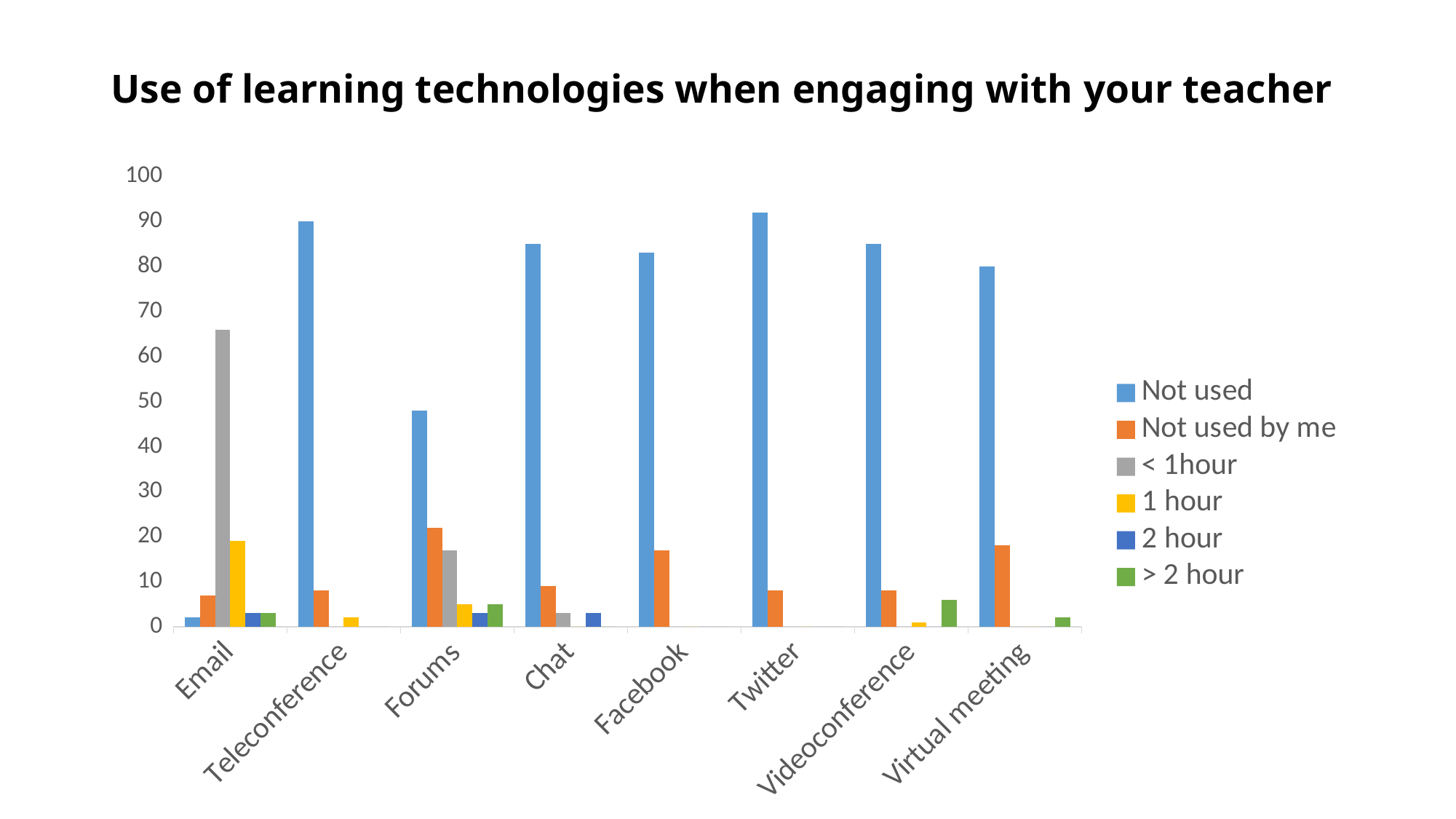
How many learning technologies are shown along the x axis? 8 What kind of chart is shown on the slide? bar chart Which technology has the highest 'Not used' value? Twitter How many series does the legend list? 6 Which is larger, the 'Not used' value for Forums or for Chat? Chat Is the 'Not used' value for Teleconference greater or less than 80? greater Is the '< 1hour' value for Email greater or less than 60? greater Which technology has the lowest 'Not used' value? Email What is the title of the chart? Use of learning technologies when engaging with your teacher Is the 'Not used' value for Forums greater or less than 50? less Which technology has the highest 'Not used by me' value? Forums Which technology has the highest '< 1hour' value? Email